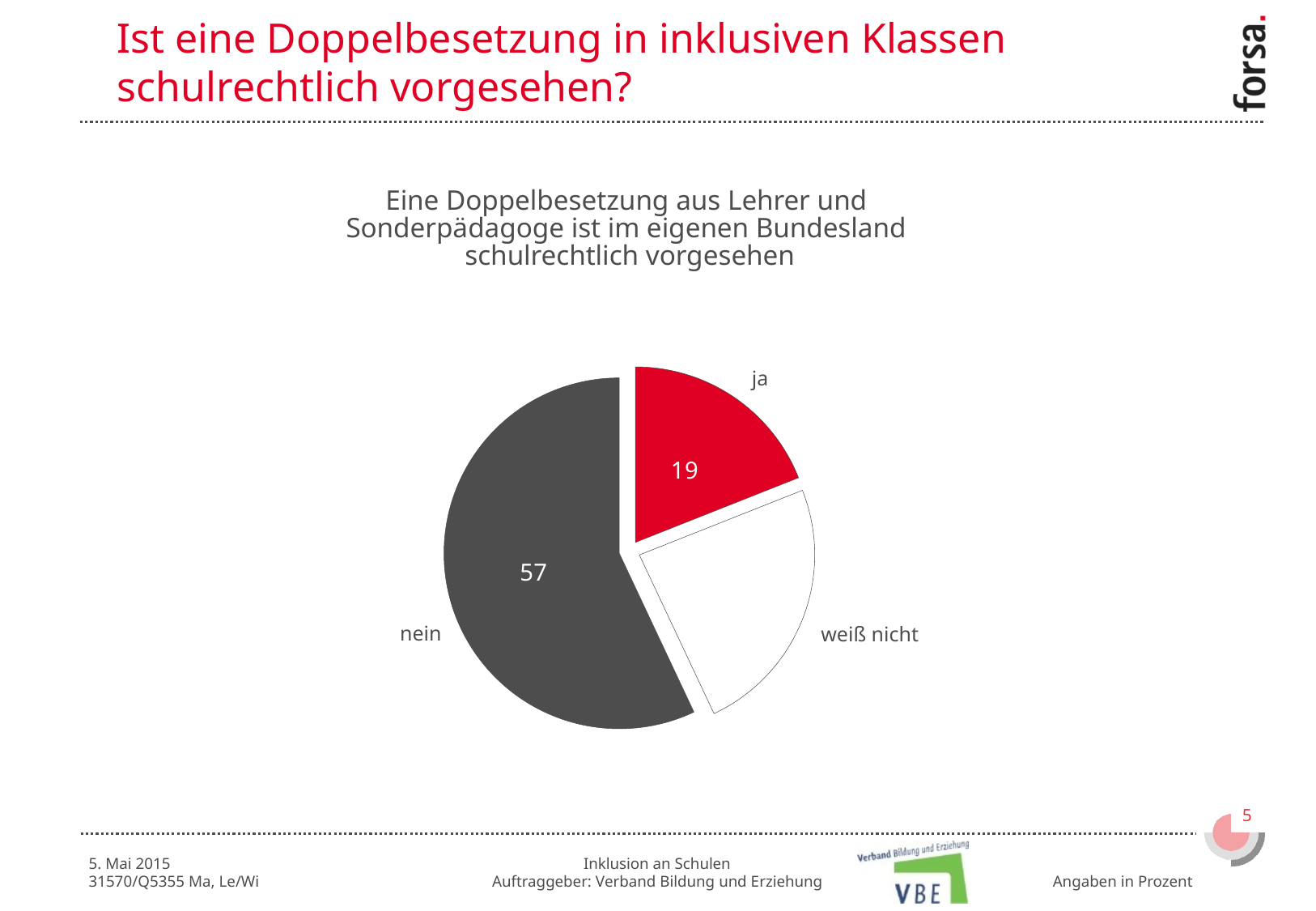
How many slices does the pie chart have? 3 What kind of chart is shown on the slide? Pie chart What value is shown for the 'nein' slice of the pie chart? 57 Which slice of the pie chart is white? weiß nicht What colour is the 'ja' slice in the pie chart? Red What is the difference between the values for 'nein' and 'ja' in the pie chart? 38 What share of the pie does the 'nein' slice represent, according to the printed label? 57 Which is larger in the pie chart, 'ja' or 'nein'? nein Which category has the largest slice in the pie chart? nein What value is shown for the 'ja' slice of the pie chart? 19